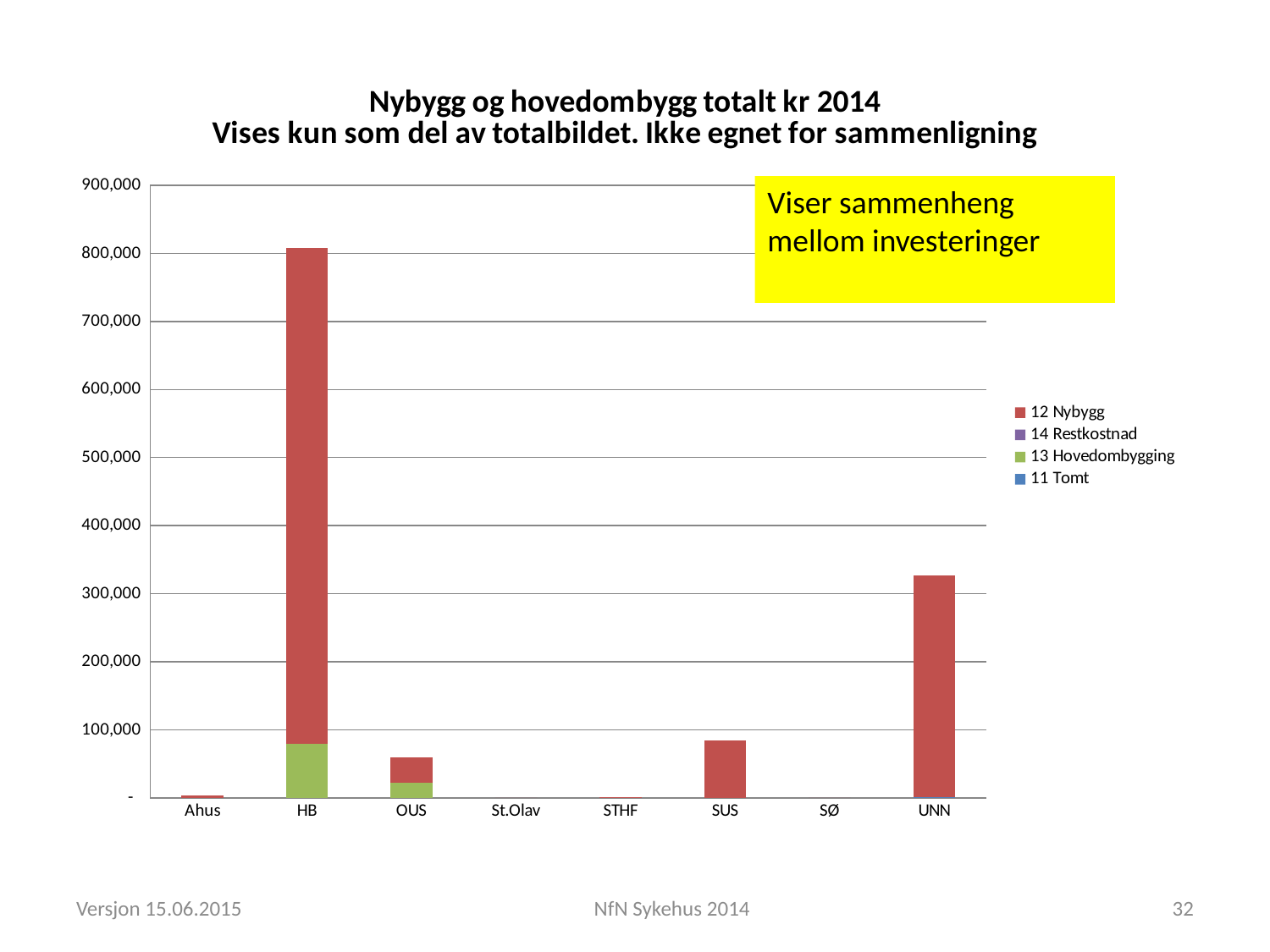
Which bar is taller, HB or UNN? HB What kind of chart is shown on the slide? Stacked bar chart Which category has the tallest bar in the chart? HB What is the first line of the chart's title? Nybygg og hovedombygg totalt kr 2014 Is the total value for UNN greater or less than 300,000? greater Which bar is taller, SUS or OUS? SUS How many series does the chart legend list? 4 Is the total value for OUS greater or less than 100,000? less Which series is shown in green in the chart legend? 13 Hovedombygging Is the total value for SUS greater or less than 100,000? less How many categories are shown along the x axis of the chart? 8